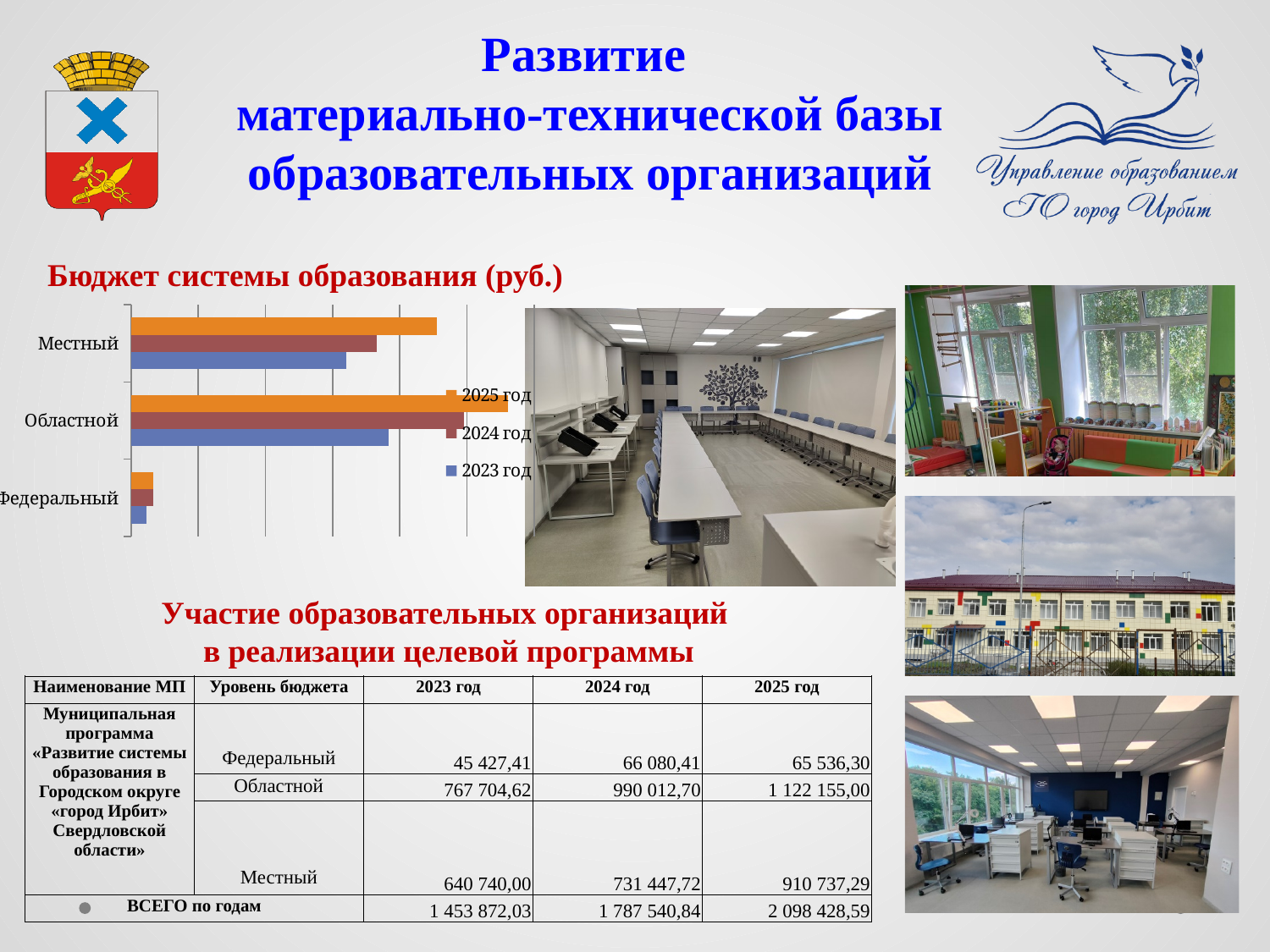
What kind of chart is shown under the heading «Бюджет системы образования (руб.)»? bar chart In the «Бюджет системы образования (руб.)» chart, do the bars for Областной rise or fall from 2023 год to 2025 год? rise How many budget-level categories are shown on the «Бюджет системы образования (руб.)» chart? 3 Which category has the longest bar in the «Бюджет системы образования (руб.)» chart? Областной Which category has the shortest bars in the «Бюджет системы образования (руб.)» chart? Федеральный In the «Бюджет системы образования (руб.)» chart, is the 2024 год bar longer for Местный or for Федеральный? Местный How many series does the legend of the «Бюджет системы образования (руб.)» chart list? 3 In the «Бюджет системы образования (руб.)» chart, is the 2025 год bar longer for Областной or for Местный? Областной Which colour represents the 2025 год series in the «Бюджет системы образования (руб.)» chart? orange Which series are listed in the legend of the «Бюджет системы образования (руб.)» chart? 2025 год, 2024 год, 2023 год In the «Бюджет системы образования (руб.)» chart, which series has the shortest bar for Местный? 2023 год In the «Бюджет системы образования (руб.)» chart, which series has the longest bar for Областной? 2025 год